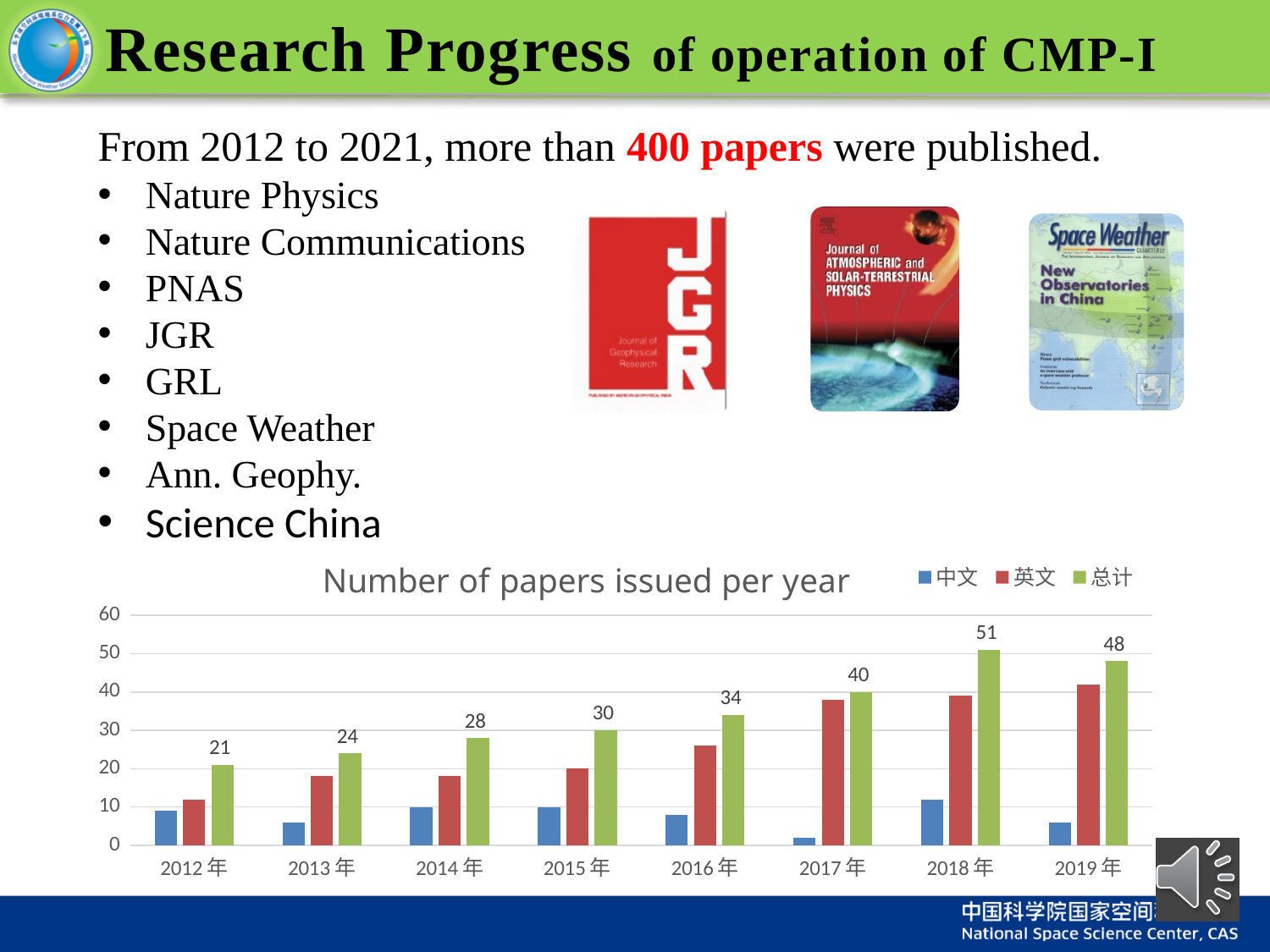
What is the difference between the 总计 values for 2018 年 and 2019 年? 3 Is the 中文 value for 2017 年 greater or less than 10? less How many years are shown on the x axis of the chart? 8 What type of chart is shown on the slide? Bar chart What is the 总计 value for 2012 年? 21 Is the 总计 value larger for 2017 年 or 2015 年? 2017 年 What is the 总计 value for 2018 年 in the chart? 51 What is the 总计 value for 2016 年? 34 How many series does the chart legend list? 3 Which year has the highest 总计 value? 2018 年 Is the 英文 value for 2017 年 greater or less than 30? greater Which year has the lowest 总计 value? 2012 年